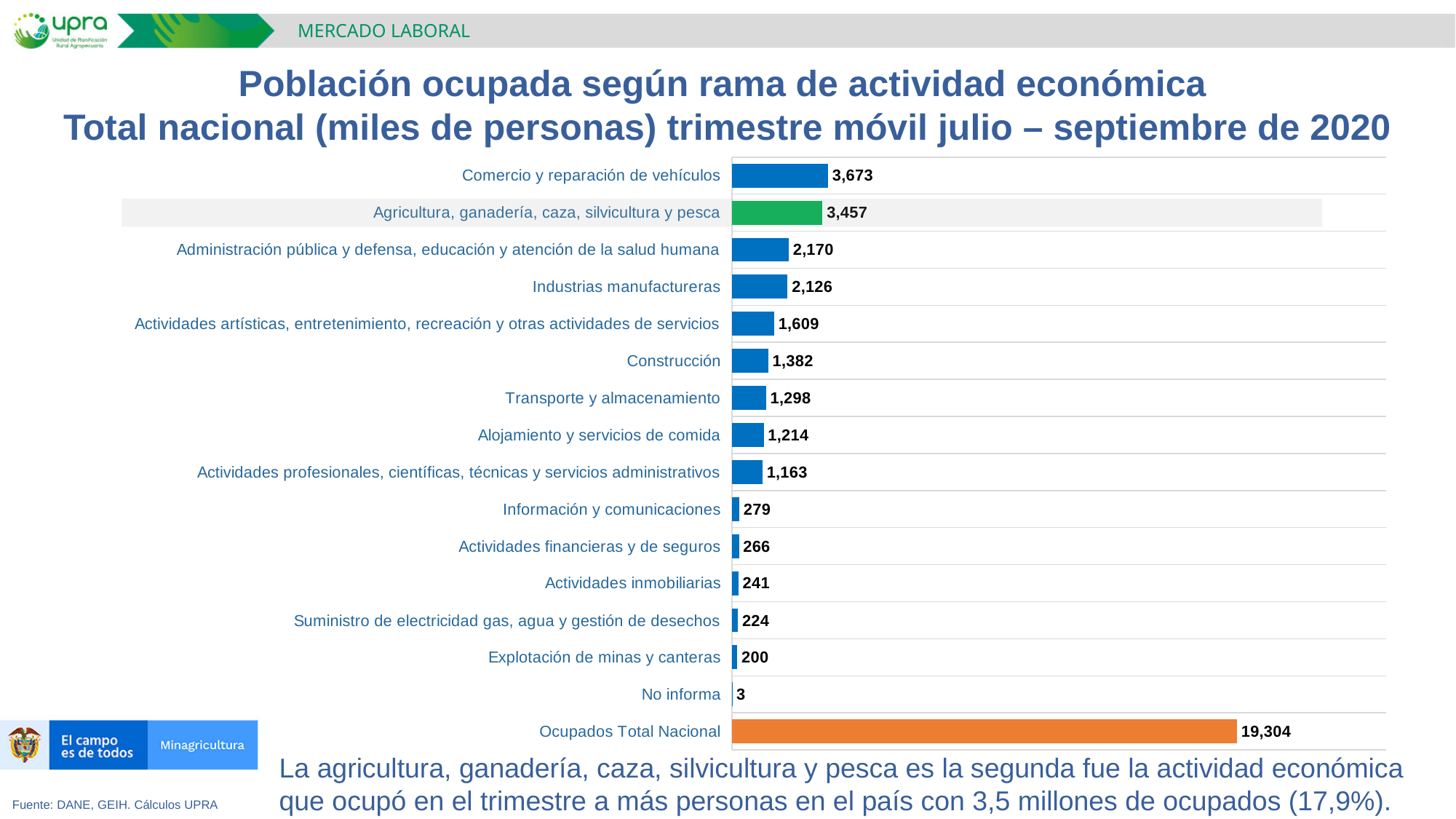
What is the value for Agricultura, ganadería, caza, silvicultura y pesca? 3,457 Excluding the Ocupados Total Nacional bar, which economic activity has the highest value? Comercio y reparación de vehículos What is the difference between Comercio y reparación de vehículos and Agricultura, ganadería, caza, silvicultura y pesca? 216 How many bars are plotted in the chart? 16 What is the value for Comercio y reparación de vehículos? 3,673 What is the difference between Administración pública y defensa, educación y atención de la salud humana and Industrias manufactureras? 44 Which bar has the lowest value? No informa What colour is the bar for Agricultura, ganadería, caza, silvicultura y pesca? Green What kind of chart is shown on the slide? Bar chart What is the value for Explotación de minas y canteras? 200 Which is larger, Construcción or Transporte y almacenamiento? Construcción What is the value for Ocupados Total Nacional? 19,304